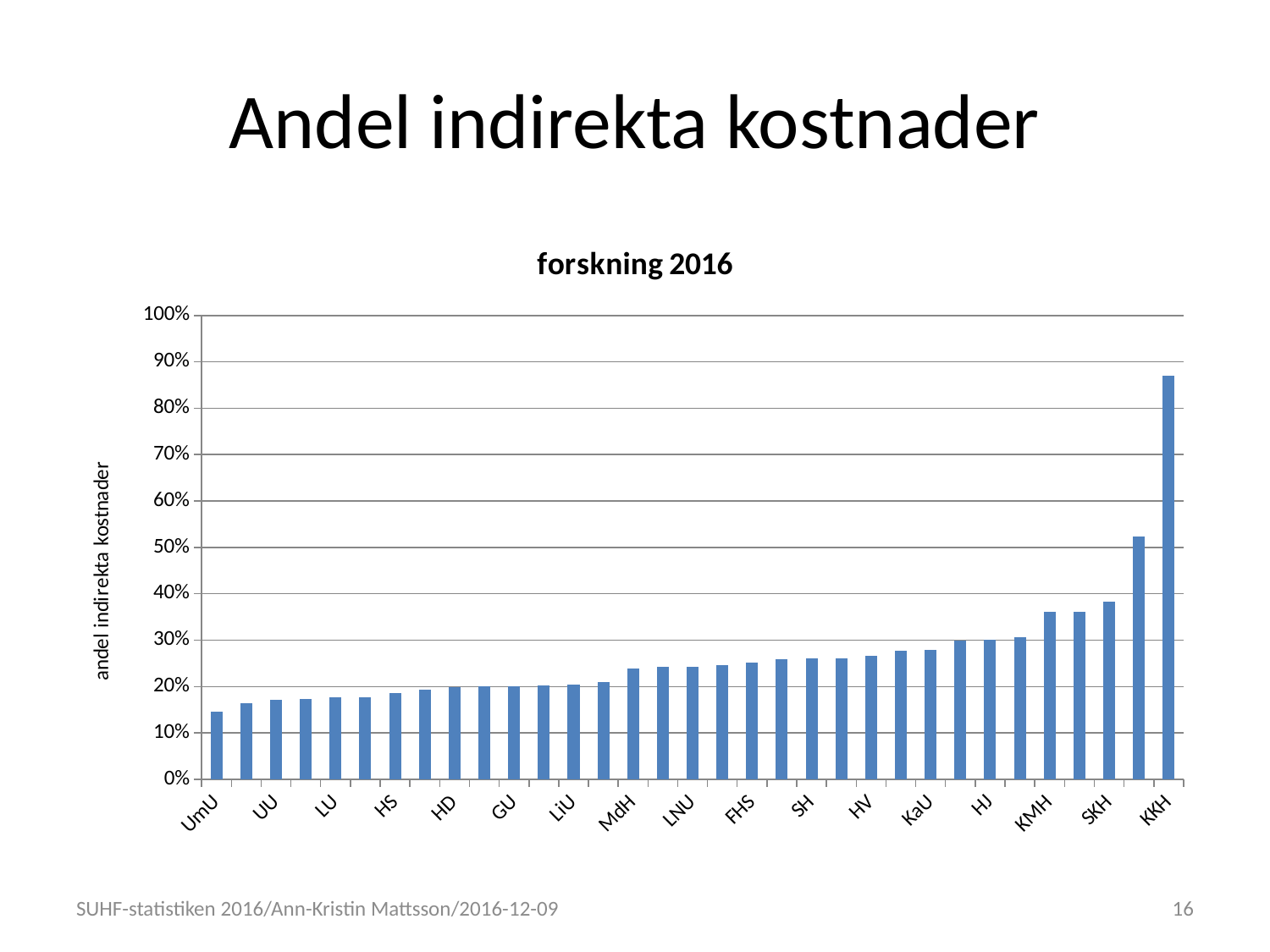
What is the title of the chart? forskning 2016 Do the values generally rise or fall from left to right along the x axis? rise Is the value for SKH greater or less than 30%? greater Is the value for KaU greater or less than 30%? less Which category has the highest value in the chart? KKH What kind of chart is shown on the slide? bar chart Is the value for UmU greater or less than 20%? less What is the label on the vertical axis of the chart? andel indirekta kostnader Which category has the lowest value in the chart? UmU Which is larger, the value for KKH or the value for SKH? KKH